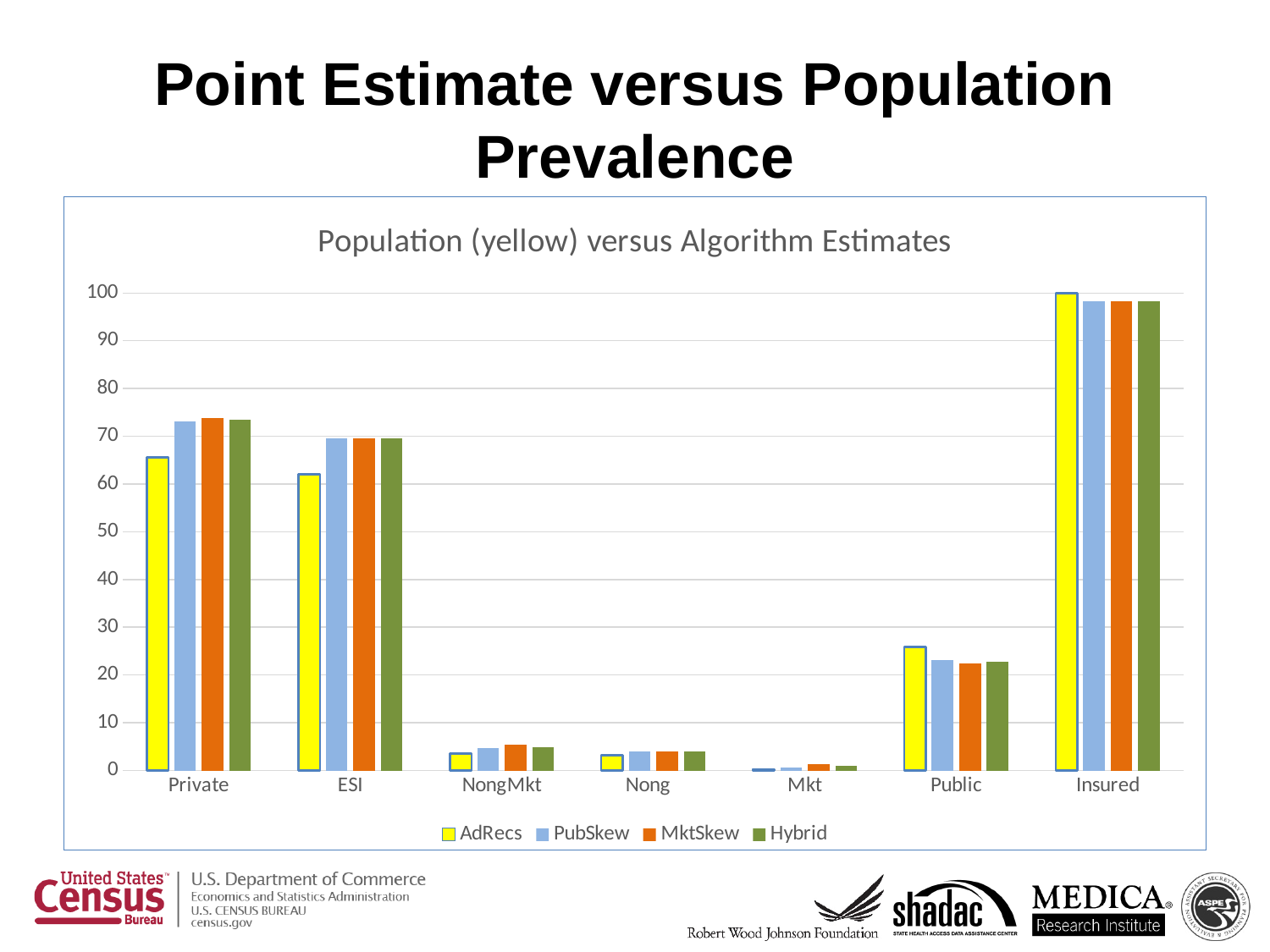
For the Public category, which is larger: the AdRecs value or the MktSkew value? AdRecs How many series does the chart's legend list? 4 Which category has the highest values in the chart? Insured Is the AdRecs value for Private greater or less than 60? greater How many categories are shown along the x axis of the chart? 7 What kind of chart is shown on the slide? bar chart Is the AdRecs value for Public greater or less than 20? greater What is the title of the chart? Population (yellow) versus Algorithm Estimates Is the PubSkew value for Insured greater or less than 90? greater For the Private category, which is larger: the AdRecs value or the Hybrid value? Hybrid Which category has the lowest values in the chart? Mkt